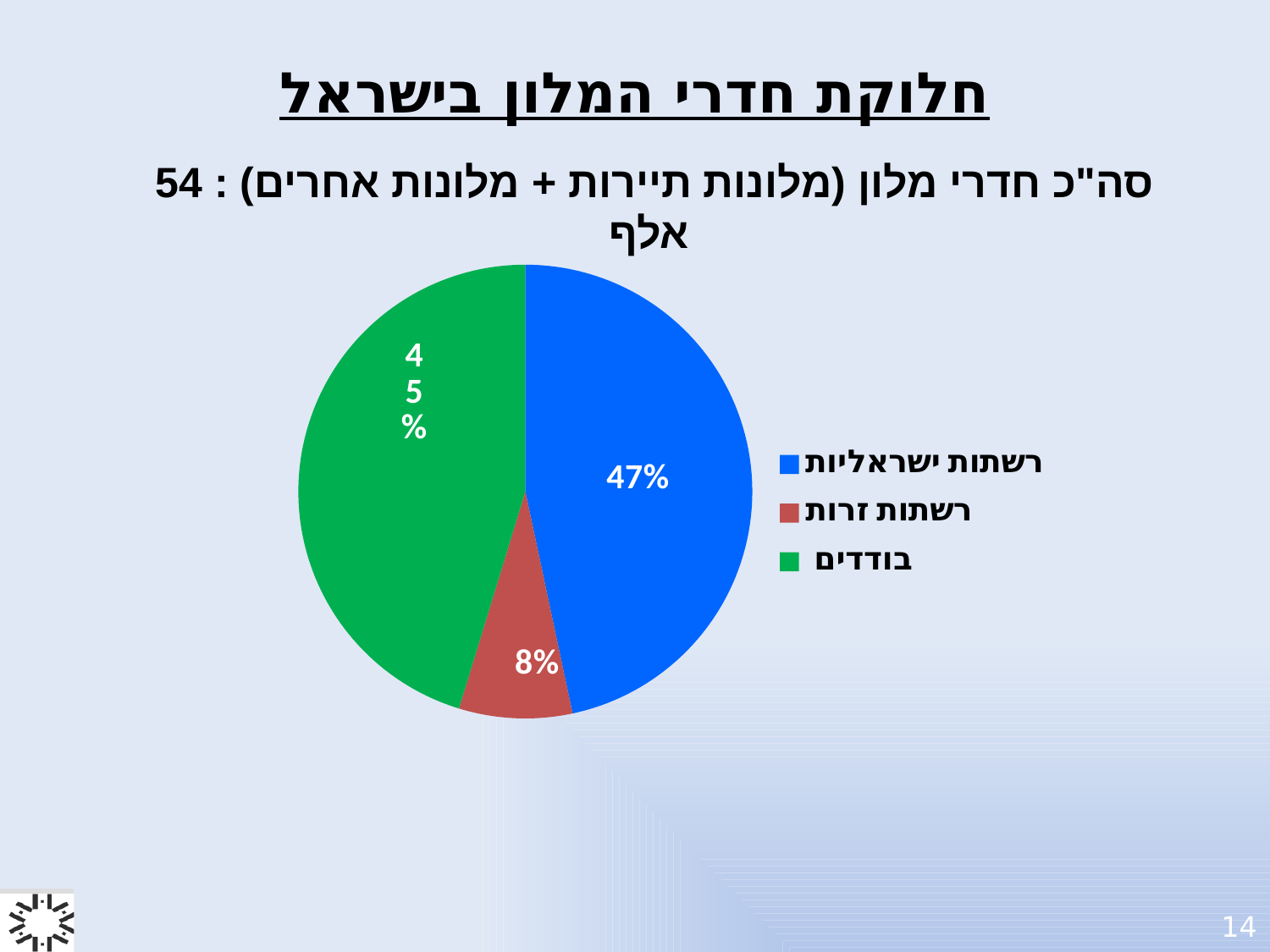
What share of the pie is labelled for בודדים? 45% What colour is the slice for בודדים? green What is the difference in percentage points between the רשתות ישראליות slice and the רשתות זרות slice? 39 What total number of hotel rooms does the chart subtitle state? 54 אלף How many entries does the legend list? 3 What share of the pie is labelled for רשתות זרות? 8% How many slices does the pie chart have? 3 What share of the pie is labelled for רשתות ישראליות? 47% Which category has the smallest slice of the pie? רשתות זרות Which is larger, the slice for בודדים or the slice for רשתות זרות? בודדים What kind of chart is shown on the slide? pie chart Which category has the largest slice of the pie? רשתות ישראליות